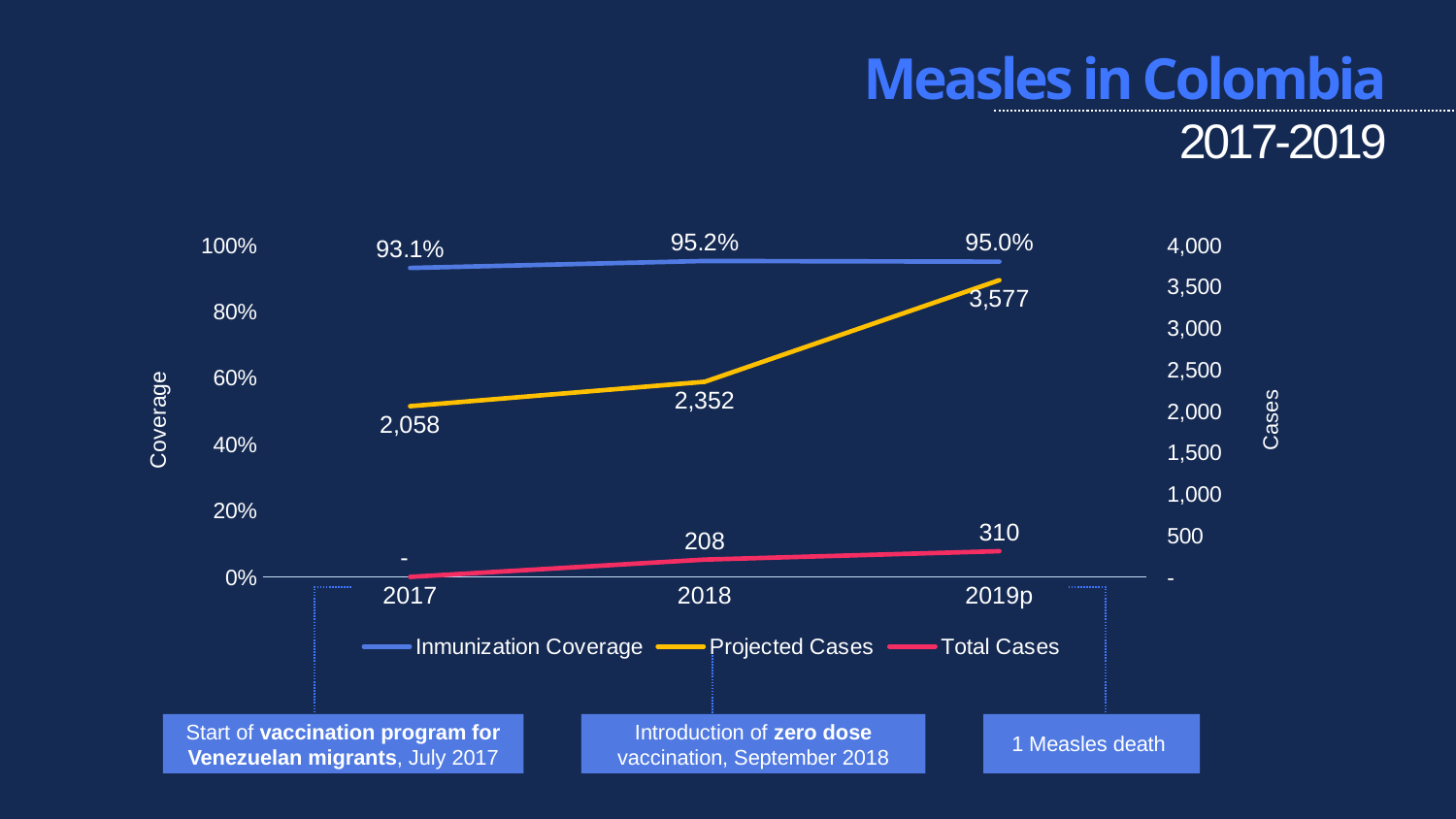
What is the title of the chart? Measles in Colombia 2017-2019 In which year is Inmunization Coverage lowest? 2017 What is the difference between Projected Cases in 2019p and 2018? 1,225 In which year is Projected Cases highest? 2019p What is the Projected Cases value for 2019p? 3,577 How many series does the legend list? 3 Does Projected Cases rise or fall from 2017 to 2019p? Rise What is the Projected Cases value for 2017? 2,058 What kind of chart is shown on the slide? Line chart What is the Total Cases value for 2018? 208 What is the Inmunization Coverage value for 2018? 95.2% Which is larger, Total Cases in 2019p or Total Cases in 2018? 2019p